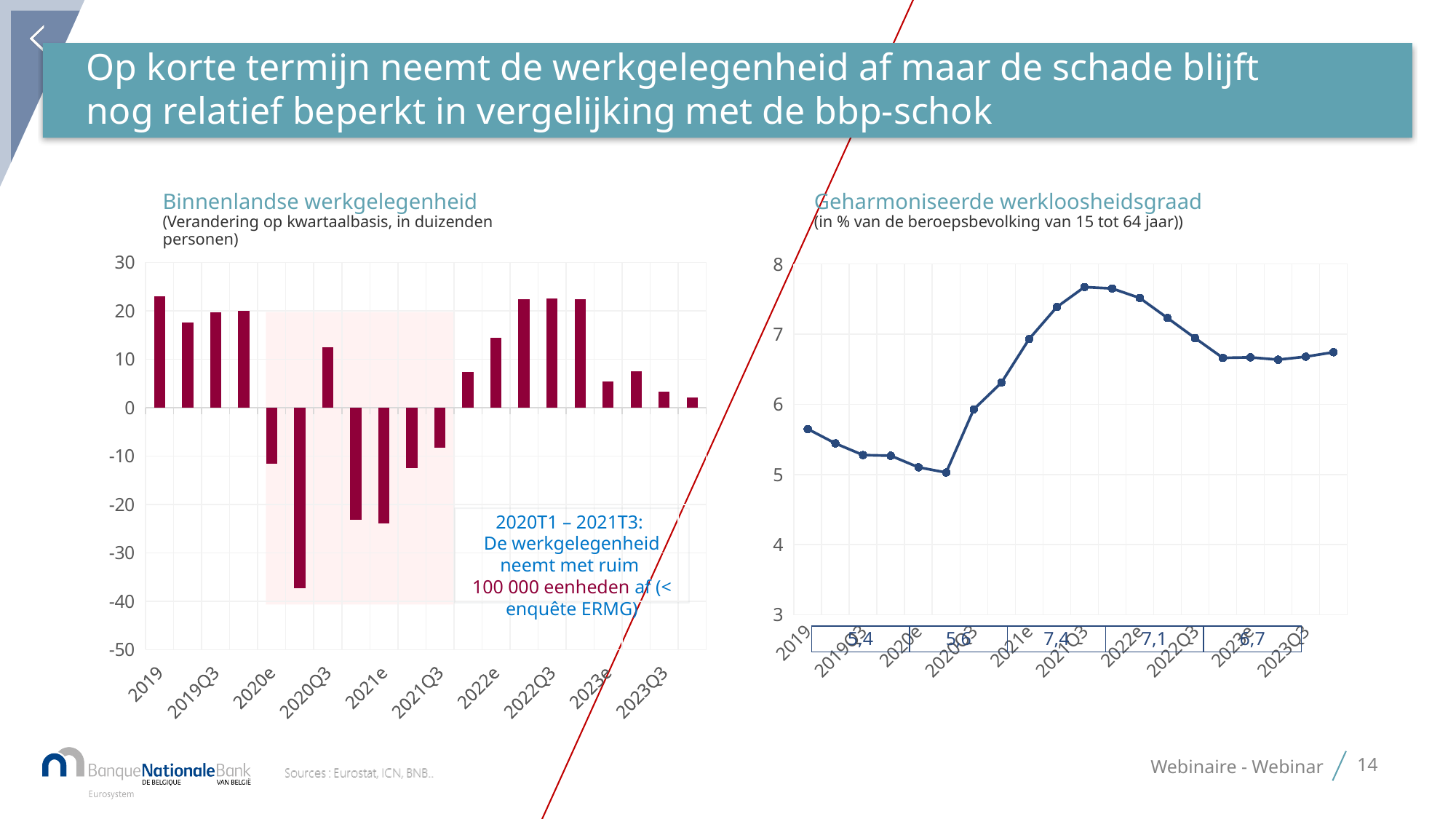
In the 'Geharmoniseerde werkloosheidsgraad' chart, is the value for 2021Q3 greater or less than 7? greater What unit is given in the subtitle of the 'Binnenlandse werkgelegenheid' chart? Verandering op kwartaalbasis, in duizenden personen In the 'Binnenlandse werkgelegenheid' chart, is the value for 2019 greater or less than 20? greater In the 'Binnenlandse werkgelegenheid' chart, which is larger, the value for 2019 or the value for 2020e? 2019 What kind of chart is the 'Binnenlandse werkgelegenheid' chart on the left? Bar chart What kind of chart is the 'Geharmoniseerde werkloosheidsgraad' chart on the right? Line chart In the 'Geharmoniseerde werkloosheidsgraad' chart, is the value for 2019 greater or less than 6? less In the 'Geharmoniseerde werkloosheidsgraad' chart, how many data points are plotted on the line? 20 In the 'Binnenlandse werkgelegenheid' chart, how many bars are plotted? 20 In the 'Binnenlandse werkgelegenheid' chart, which is larger, the value for 2021e or the value for 2022e? 2022e In the 'Geharmoniseerde werkloosheidsgraad' chart, does the line rise or fall between 2020Q3 and 2021Q3? Rises